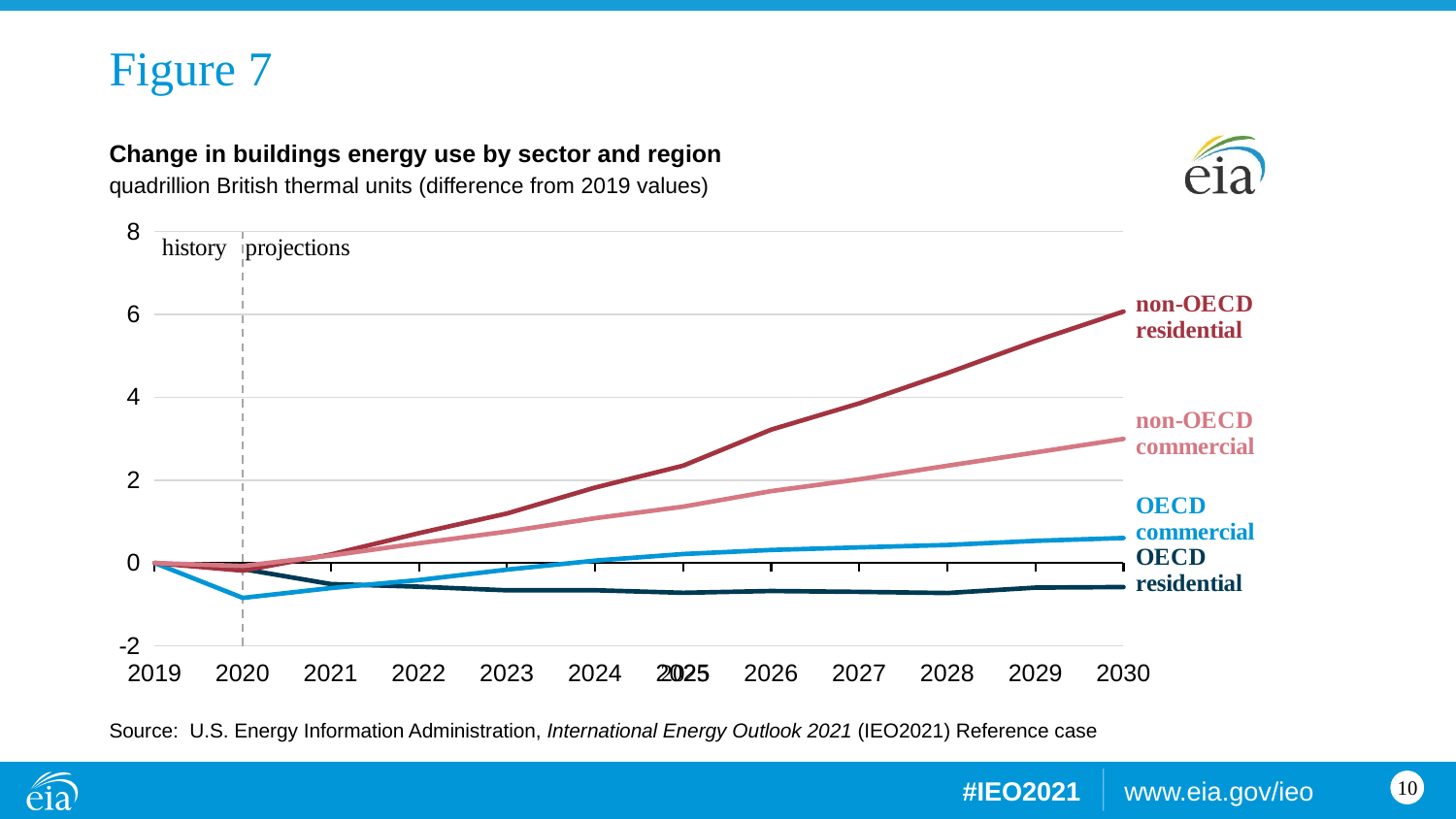
Which series has the highest value in 2030? non-OECD residential Is the value for OECD commercial in 2030 greater or less than 2? less How many series are plotted on the chart? 4 In 2030, which is larger: non-OECD commercial or OECD commercial? non-OECD commercial Is the value for non-OECD commercial in 2030 greater or less than 4? less How many years are labelled along the x axis? 12 Does the non-OECD residential line rise or fall from 2020 to 2030? rise Is the value for OECD residential in 2030 greater or less than 0? less What unit is the chart measured in, according to the subtitle? quadrillion British thermal units (difference from 2019 values) Which series has the lowest value in 2030? OECD residential What kind of chart is shown on the slide? line chart